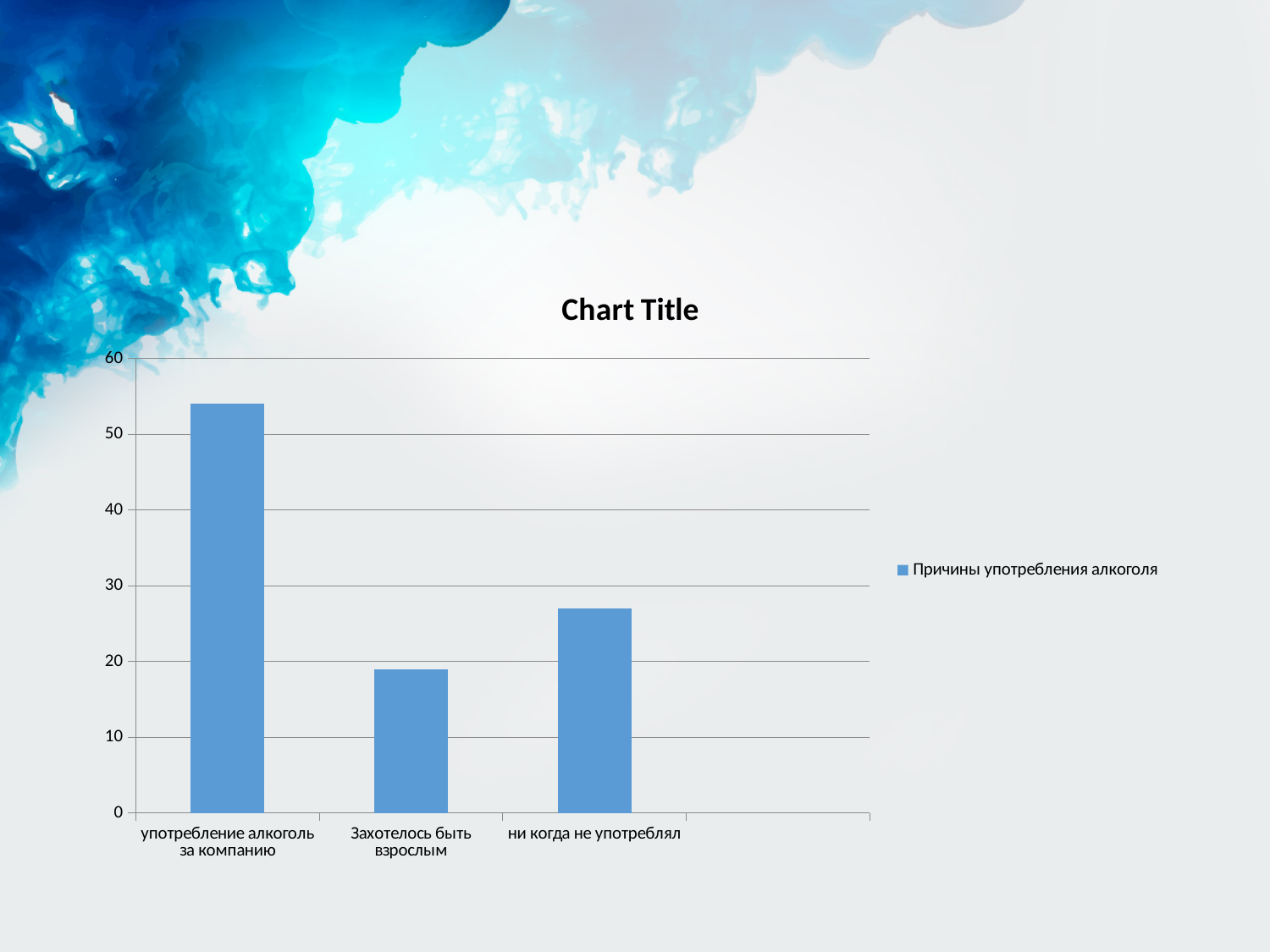
Is the value for 'ни когда не употреблял' greater or less than 20? greater Is the value for 'употребление алкоголь за компанию' greater or less than 50? greater Which category has the highest bar in the chart? употребление алкоголь за компанию What kind of chart is shown on the slide? bar chart What series name is shown in the chart legend? Причины употребления алкоголя Which category has the lowest bar in the chart? Захотелось быть взрослым What is the title of the chart? Chart Title Which is larger: the value for 'ни когда не употреблял' or the value for 'Захотелось быть взрослым'? ни когда не употреблял How many categories are shown on the x axis of the chart? 3 How many series does the chart legend list? 1 Is the value for 'ни когда не употреблял' greater or less than 30? less